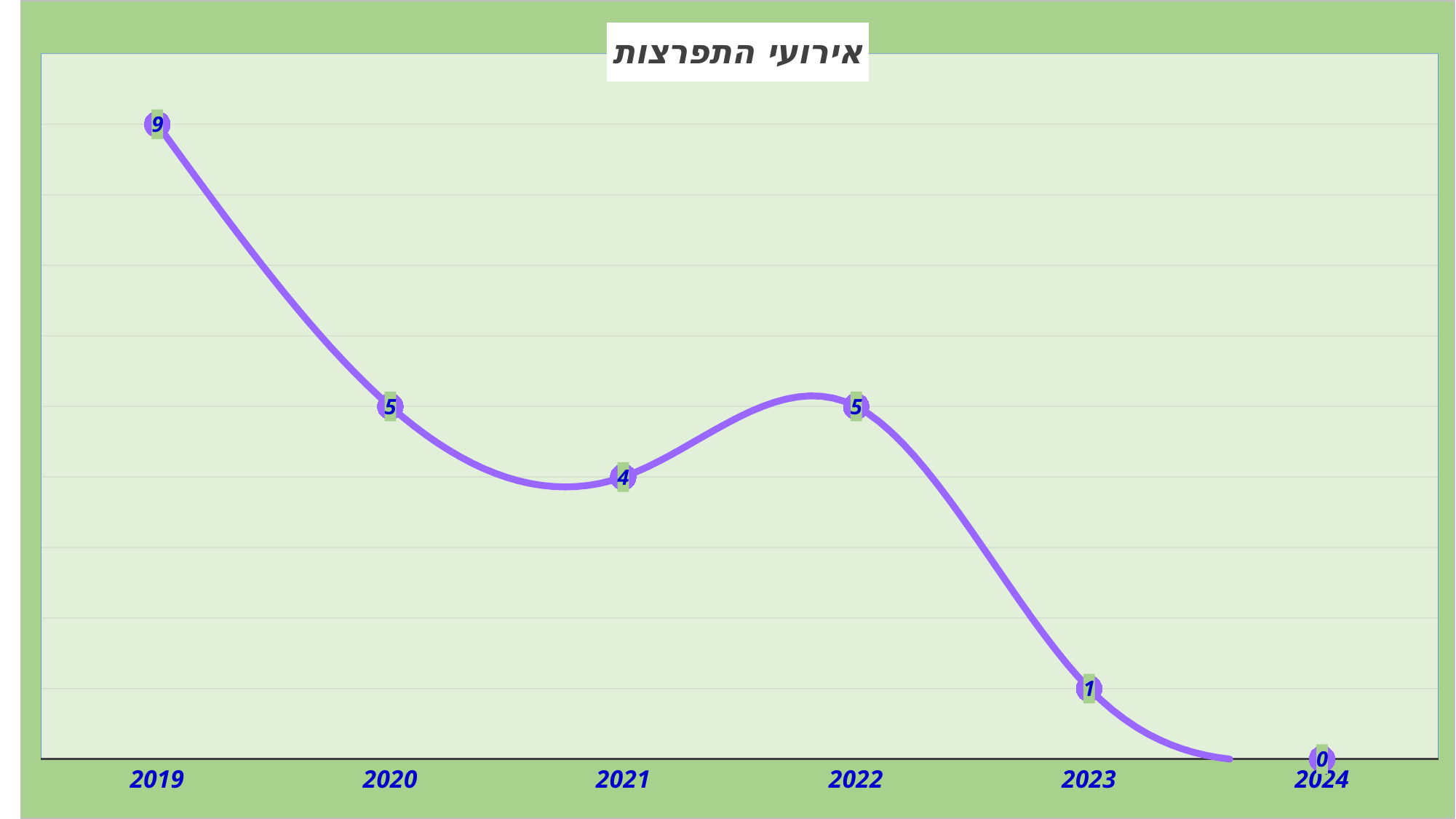
What kind of chart is shown? line chart Which year has the lowest value? 2024 What is the value for 2021? 4 Which year has the highest value? 2019 What is the value for 2024? 0 What is the value for 2023? 1 How many years are plotted on the x axis? 6 What is the difference between the values for 2022 and 2023? 4 What is the title of the chart? אירועי התפרצות Which is larger, the value for 2021 or the value for 2022? 2022 What is the difference between the values for 2019 and 2020? 4 What is the value for 2019? 9